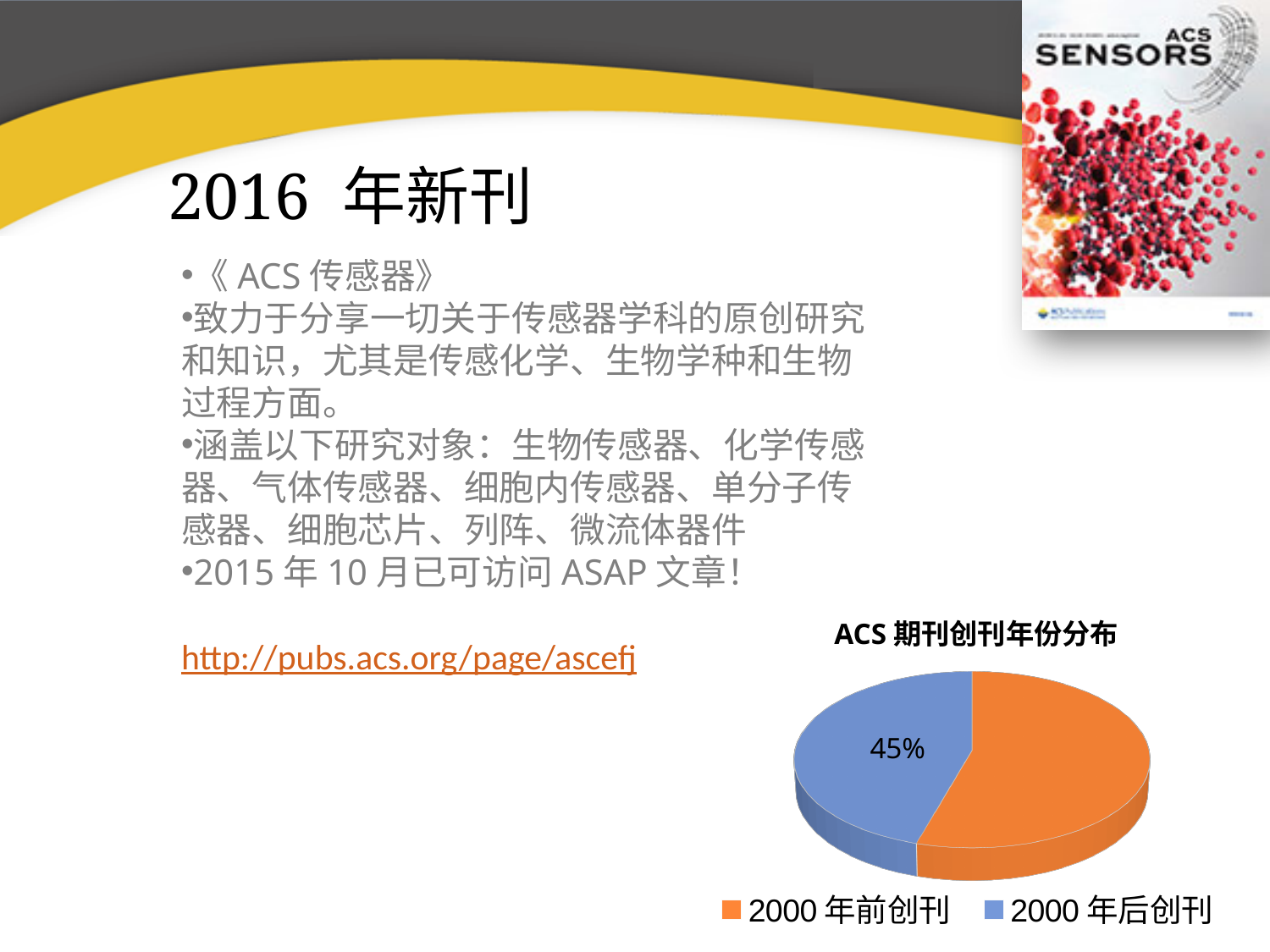
Which is larger in the pie chart, 2000 年前创刊 or 2000 年后创刊? 2000 年前创刊 How many entries does the chart's legend list? 2 What share of the pie does the 2000 年后创刊 slice represent? 45% Which slice of the pie chart is the largest? 2000 年前创刊 What is the title of the chart on the slide? ACS 期刊创刊年份分布 What kind of chart is shown on the slide? pie chart Which slice of the pie chart is the smallest? 2000 年后创刊 What percentage is shown for 2000 年后创刊 in the pie chart? 45% What colour is the 2000 年前创刊 slice in the pie chart? orange Is the share for 2000 年后创刊 greater or less than 50%? less How many slices does the pie chart have? 2